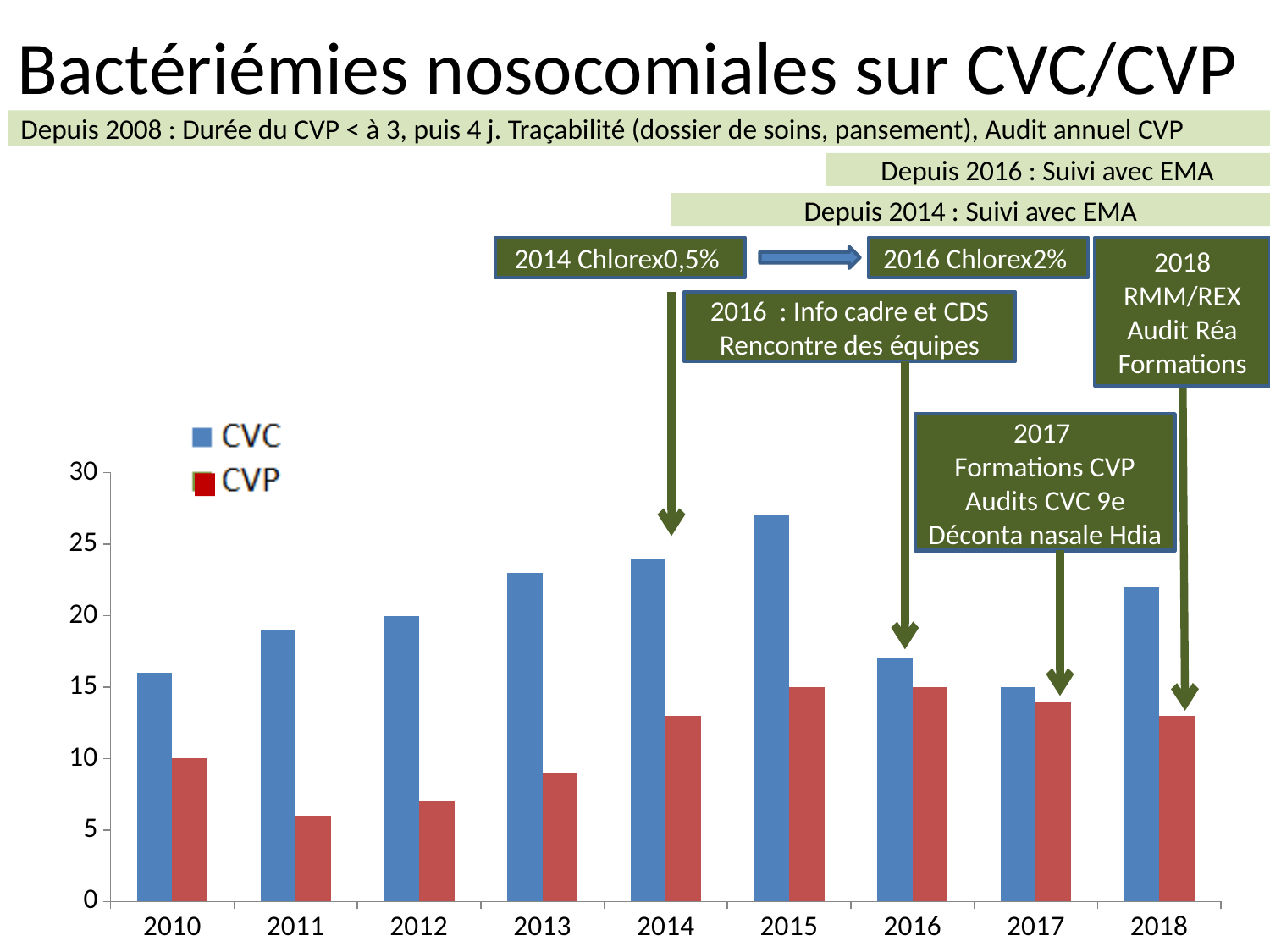
Is the CVP value for 2011 greater or less than 10? less Do the CVC values rise or fall from 2010 to 2015? rise Is the CVP value for 2014 greater or less than 15? less What are the two series named in the chart legend? CVC and CVP Which colour represents the CVP series in the chart? red What type of chart is shown on the slide? bar chart Is the CVC value for 2015 greater or less than 25? greater How many series does the chart legend list? 2 How many years are shown on the x axis of the chart? 9 In which year is the CVC value highest? 2015 In 2015, which series has the larger value, CVC or CVP? CVC